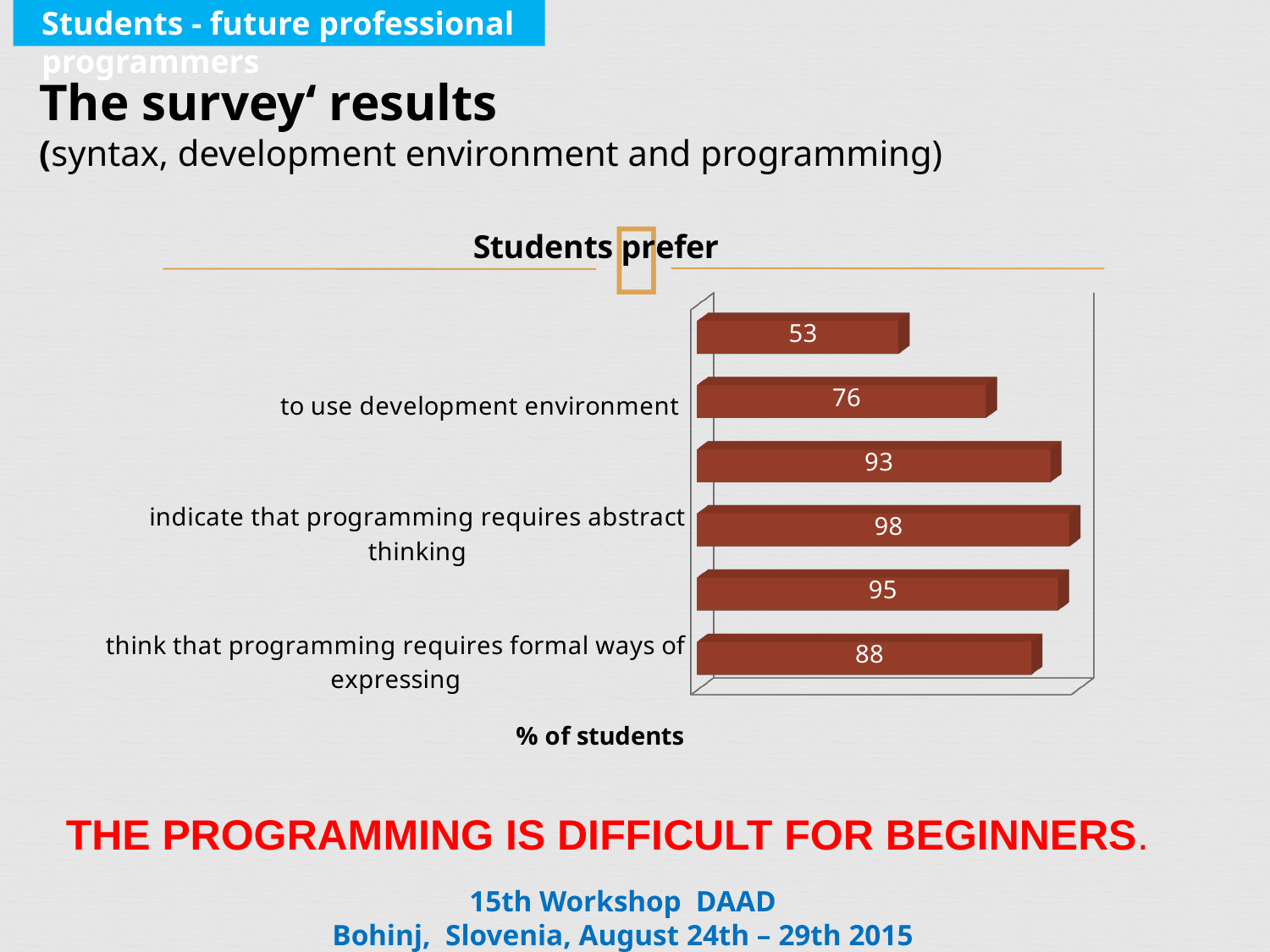
Which is larger: the value for 'indicate that programming requires abstract thinking' or the value for 'think that programming requires formal ways of expressing'? indicate that programming requires abstract thinking What is the difference between the values for 'think that programming requires formal ways of expressing' and 'to use development environment'? 12 What is the title of the chart? Students prefer What is the lowest value shown in the chart? 53 How many bars does the chart show? 6 What is the difference between the values for 'indicate that programming requires abstract thinking' and 'to use development environment'? 22 What is the value for 'to use development environment'? 76 What is the highest value shown in the chart? 98 What is the value for 'think that programming requires formal ways of expressing'? 88 What kind of chart is shown on the slide? bar chart What is the label of the horizontal axis of the chart? % of students What is the value for 'indicate that programming requires abstract thinking'? 98